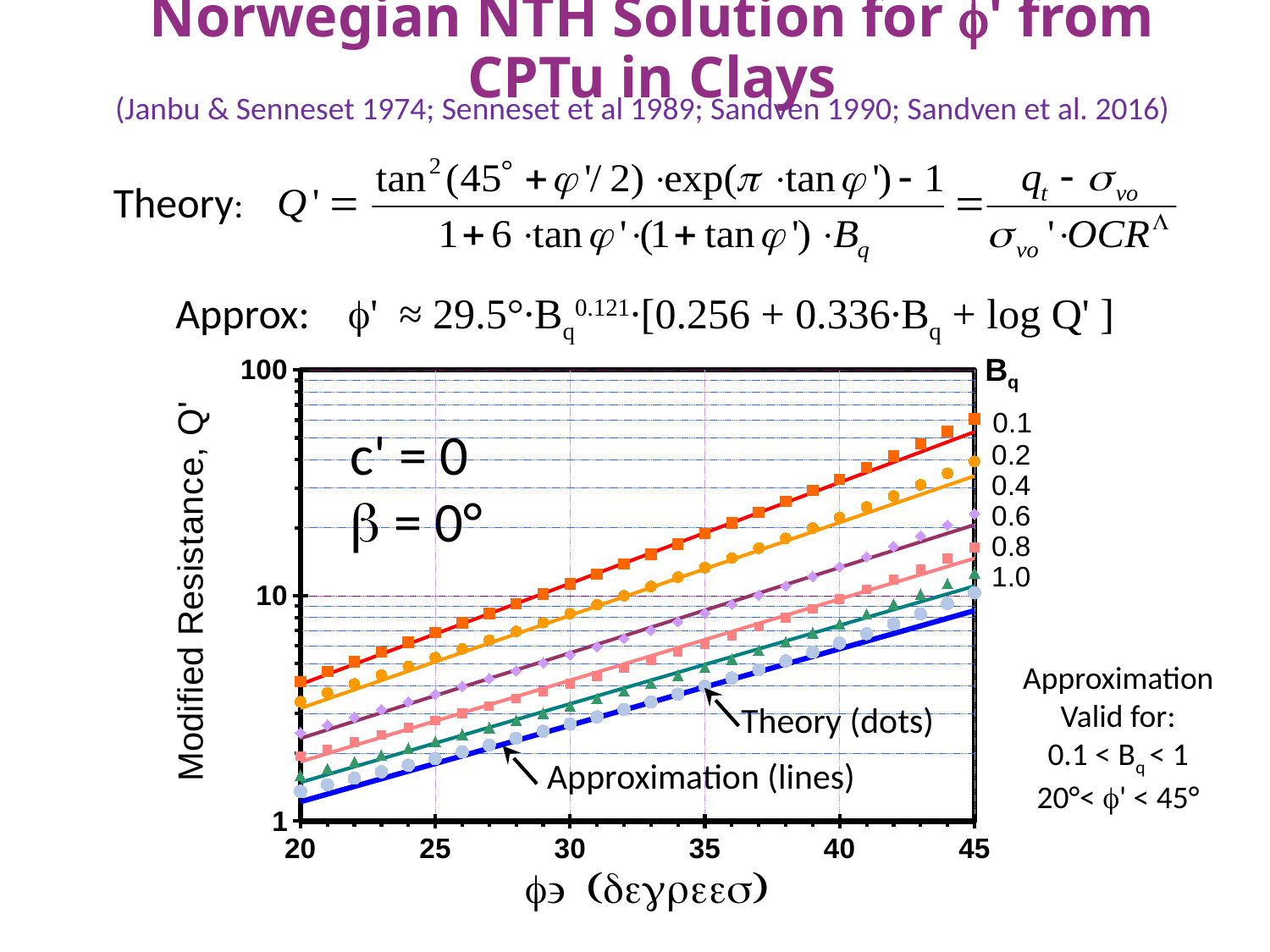
What is the label of the y-axis of the chart? Modified Resistance, Q' At φ' = 30 degrees, which has the larger Q': the B_q = 0.1 line or the B_q = 1.0 line? B_q = 0.1 Is the value of Q' for the B_q = 0.1 line at φ' = 45 degrees greater or less than 10? greater According to the chart annotations, what do the dots represent and what do the lines represent? Dots: Theory; Lines: Approximation How many B_q values are listed in the legend of the chart? 6 What kind of chart is shown on the slide? line chart with scatter points Is the value of Q' for the B_q = 0.1 line at φ' = 35 degrees greater or less than 10? greater Which B_q series has the lowest Modified Resistance Q' across the chart? 1.0 Is the value of Q' for the B_q = 1.0 line at φ' = 20 degrees greater or less than 10? less How many labelled tick marks are on the x-axis of the chart? 6 Does Modified Resistance Q' rise or fall as φ' increases from 20 to 45 degrees? rise Which B_q series has the highest Modified Resistance Q' across the chart? 0.1